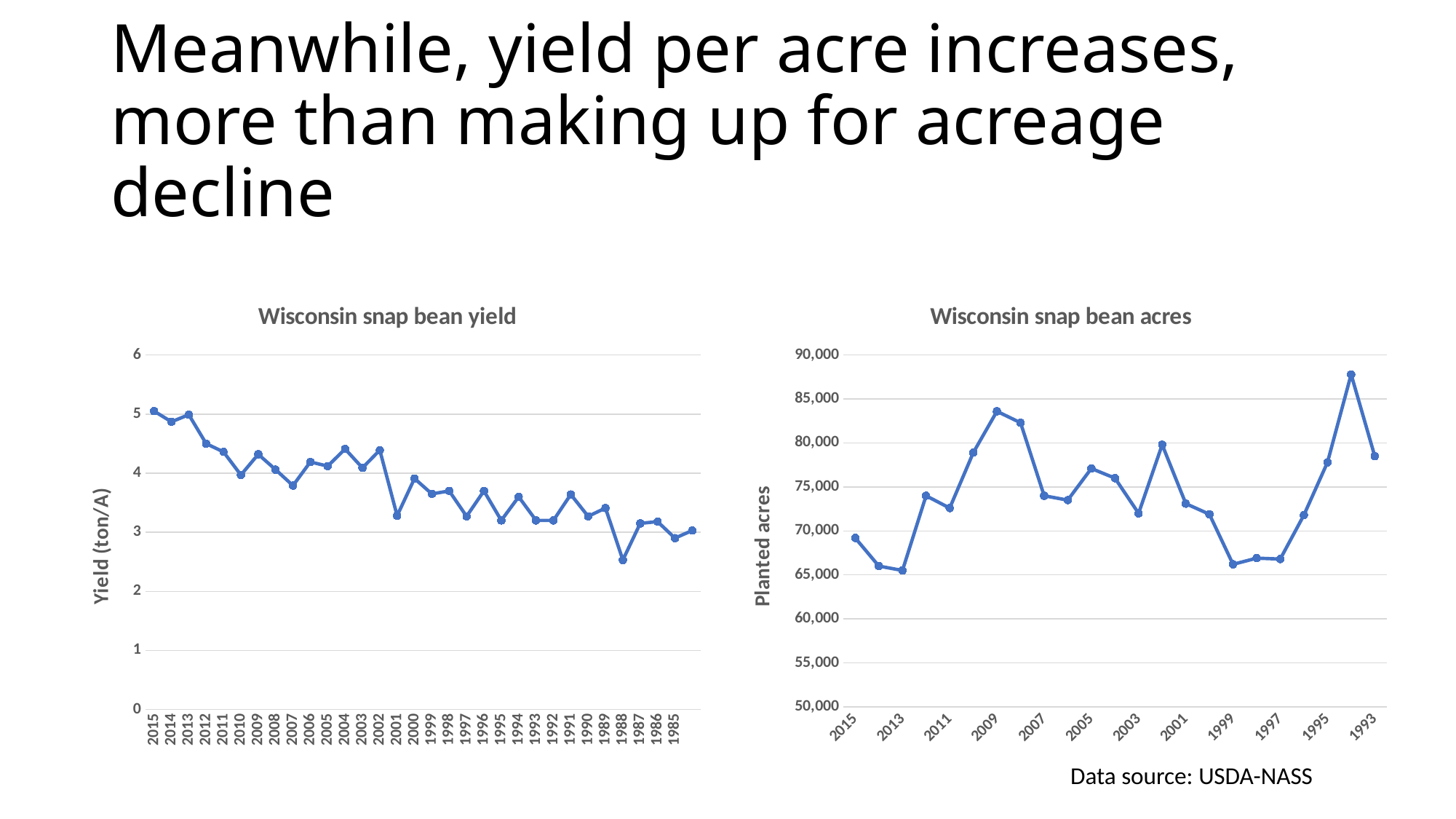
In the "Wisconsin snap bean yield" chart, moving along the x axis from 2015 on the left to 1985 on the right, do the yield values generally rise or fall? fall In the "Wisconsin snap bean yield" chart, which year has the lowest yield? 1988 In the "Wisconsin snap bean yield" chart, how many years are labelled on the x axis? 31 In the "Wisconsin snap bean acres" chart, is the value for 2013 greater or less than 70,000? less In the "Wisconsin snap bean acres" chart, how many data points are plotted? 23 What kind of chart is the "Wisconsin snap bean yield" chart? line chart In the "Wisconsin snap bean yield" chart, is the value for 2004 greater or less than 4? greater In the "Wisconsin snap bean yield" chart, which year has the higher yield, 2015 or 1985? 2015 In the "Wisconsin snap bean yield" chart, is the value for 2001 greater or less than 4? less In the "Wisconsin snap bean acres" chart, which year has the highest planted acres? 1994 What kind of chart is the "Wisconsin snap bean acres" chart? line chart